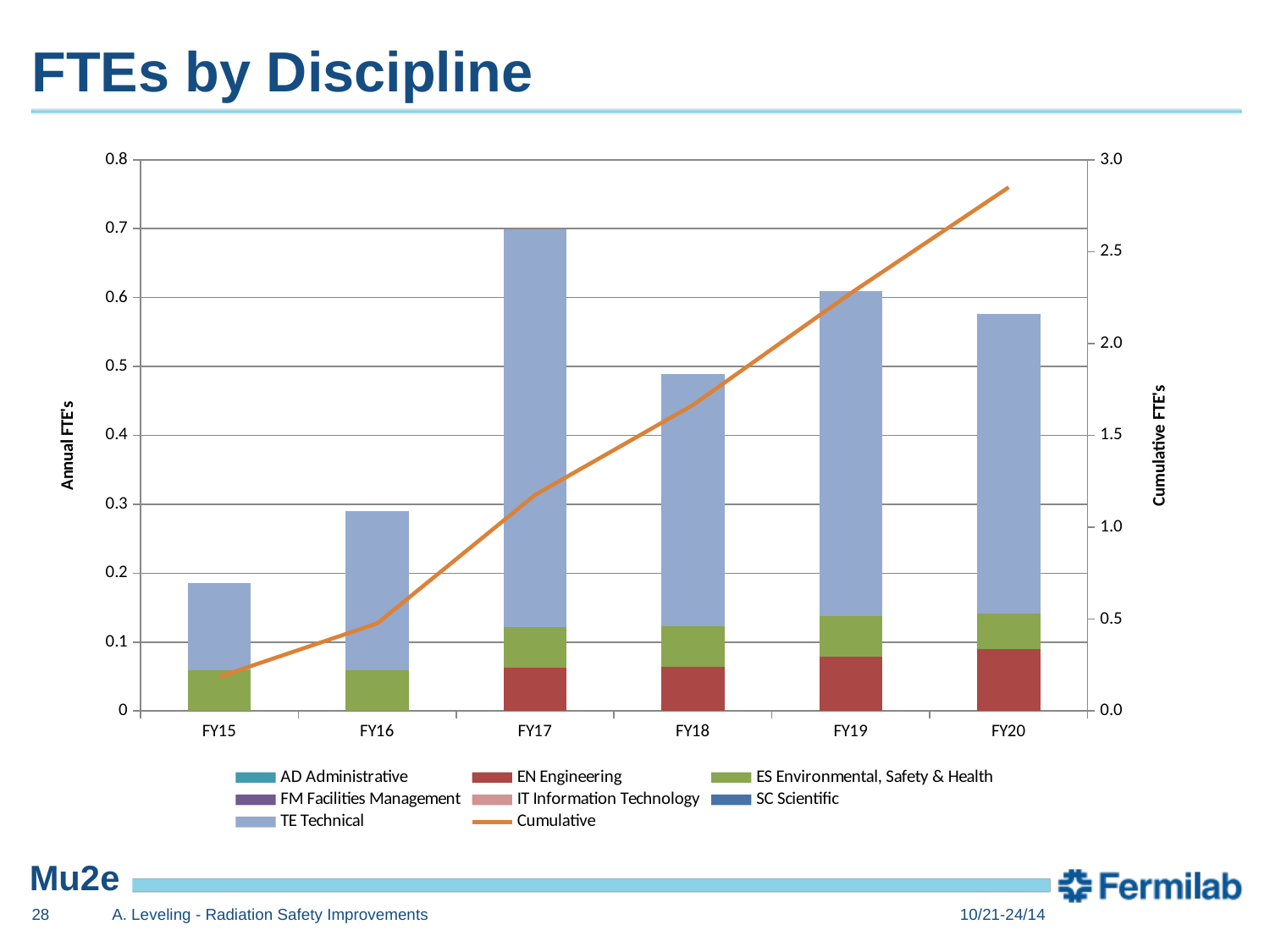
How many entries does the legend list? 8 Is the Cumulative FTE value at FY20 greater or less than 2.5? greater Which fiscal year has the shortest stacked bar? FY15 Does the Cumulative line rise or fall from FY15 to FY20? Rises How many fiscal years are shown on the x axis? 6 Which has the taller stacked bar, FY18 or FY19? FY19 Is the total annual FTE value for FY15 greater or less than 0.2? less What is the title of the right-hand vertical axis? Cumulative FTE's What kind of chart is shown on the slide? Stacked bar chart with a line Is the total annual FTE value for FY17 greater or less than 0.6? greater Which fiscal year has the tallest stacked bar? FY17